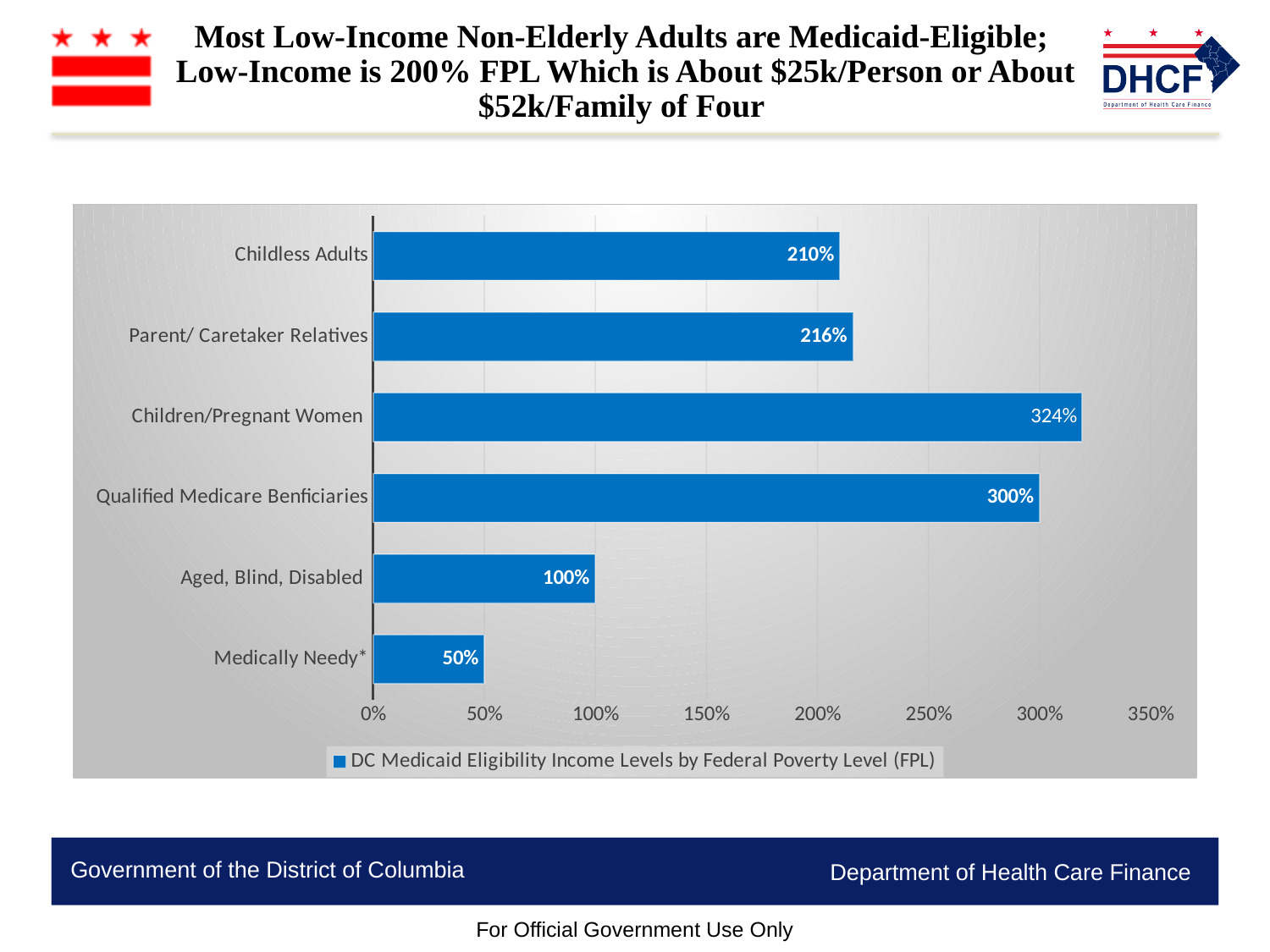
Which category has the lowest value? Medically Needy* What is the value for Childless Adults? 210% What is the value for Children/Pregnant Women? 324% Which is larger, the value for Aged, Blind, Disabled or the value for Medically Needy*? Aged, Blind, Disabled What kind of chart is shown on the slide? Bar chart What is the difference between the values for Children/Pregnant Women and Qualified Medicare Benficiaries? 24% What is the value for Medically Needy*? 50% How many categories are shown in the chart? 6 Which category has the highest value? Children/Pregnant Women Is the value for Qualified Medicare Benficiaries greater or less than 250%? greater What series name does the legend show? DC Medicaid Eligibility Income Levels by Federal Poverty Level (FPL) What is the value for Parent/ Caretaker Relatives? 216%